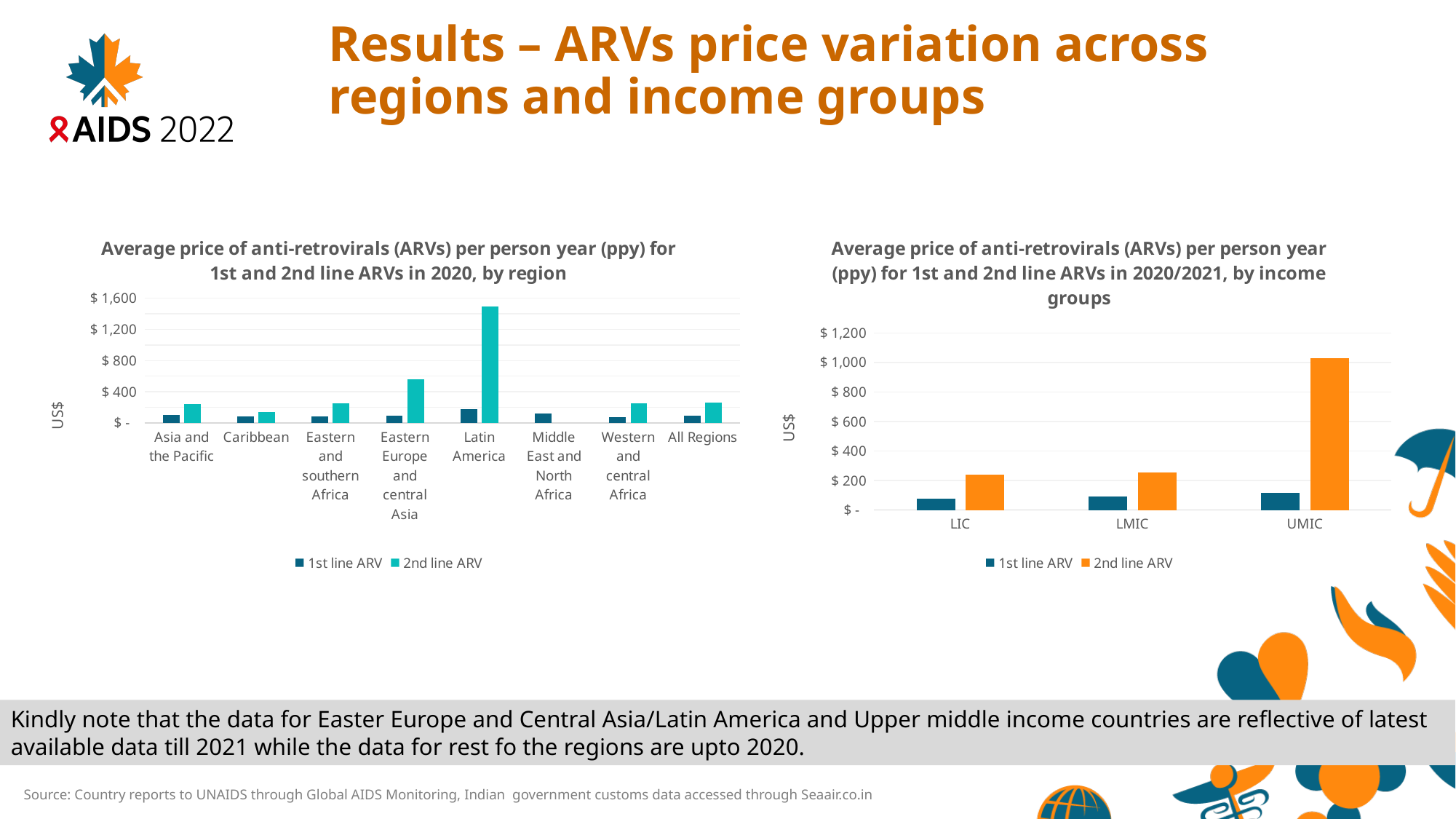
How many series does the legend of the left chart (by region) list? 2 In the left chart (by region), is the 2nd line ARV value for Eastern Europe and central Asia greater or less than $400? greater In the right chart (by income groups), do the 2nd line ARV values rise or fall from LIC to UMIC? Rise How many regions are shown on the x axis of the left chart (by region)? 8 In the left chart (by region), which is larger for Latin America: the 1st line ARV price or the 2nd line ARV price? 2nd line ARV In the left chart (by region), is the 2nd line ARV value for Latin America greater or less than $1,200? greater In the right chart (by income groups), what colour represents the 2nd line ARV series? Orange How many income groups are shown on the x axis of the right chart (by income groups)? 3 In the right chart (by income groups), which income group has the highest 2nd line ARV price? UMIC In the left chart (by region), which region has the highest 2nd line ARV price? Latin America What kind of chart is the left chart, 'Average price of anti-retrovirals (ARVs) per person year (ppy) for 1st and 2nd line ARVs in 2020, by region'? Bar chart In the right chart (by income groups), is the 2nd line ARV value for UMIC greater or less than $800? greater